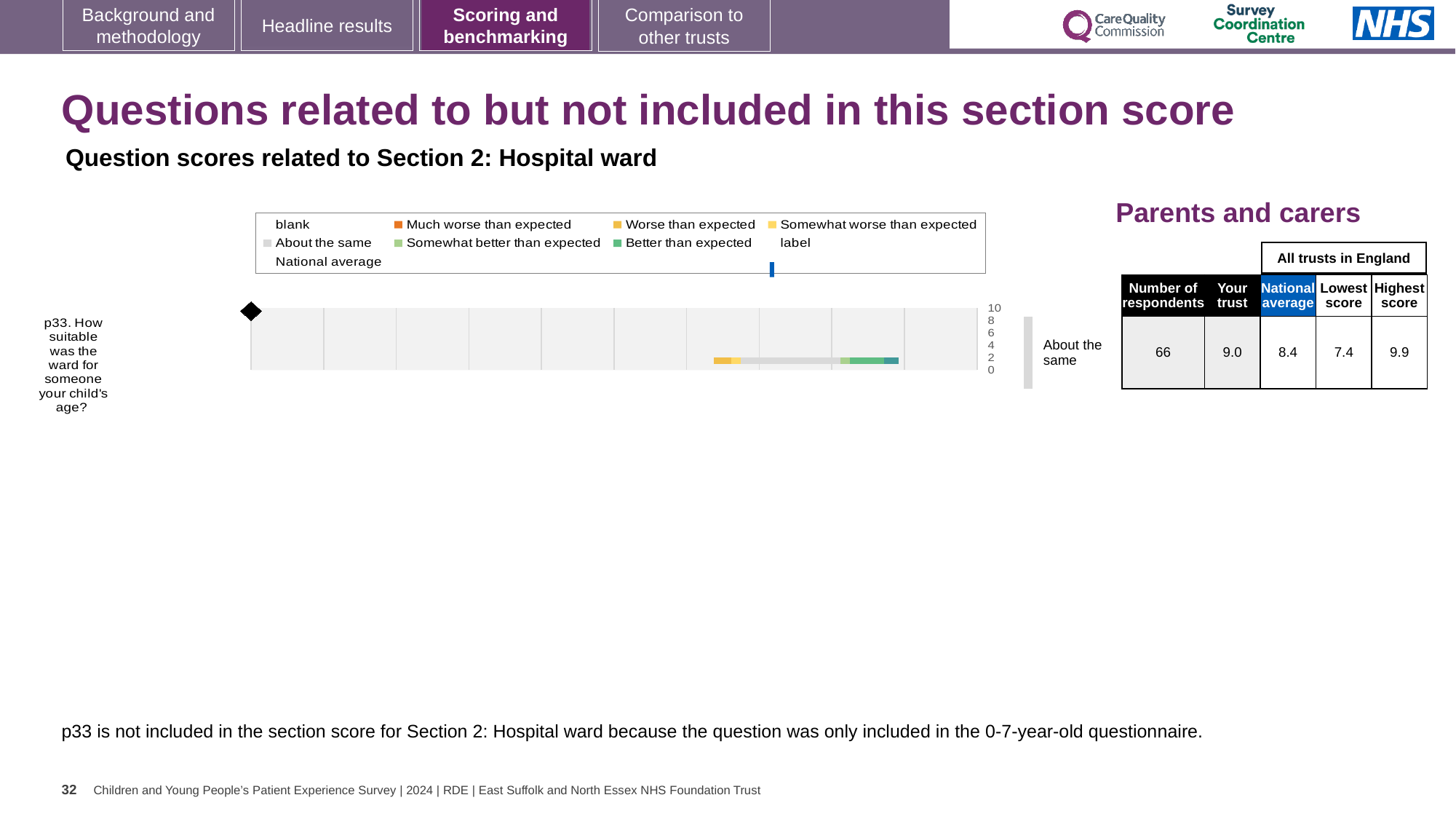
What is the 'Your trust' score for p33 in the Parents and carers table? 9.0 Which question is plotted in the chart? p33. How suitable was the ward for someone your child's age? What benchmark category label is shown to the right of the p33 bar? About the same For p33, what is the difference between the highest score and the lowest score among all trusts in England? 2.5 What kind of chart is used to show the p33 question score? bar chart How many respondents answered p33 according to the Parents and carers table? 66 For p33, how much higher is the 'Your trust' score than the national average? 0.6 What is the national average score for p33 in the Parents and carers table? 8.4 What is the highest score among all trusts in England for p33? 9.9 How many questions are plotted in the chart? 1 For p33, which is larger: the 'Your trust' score or the national average? Your trust What is the lowest score among all trusts in England for p33? 7.4